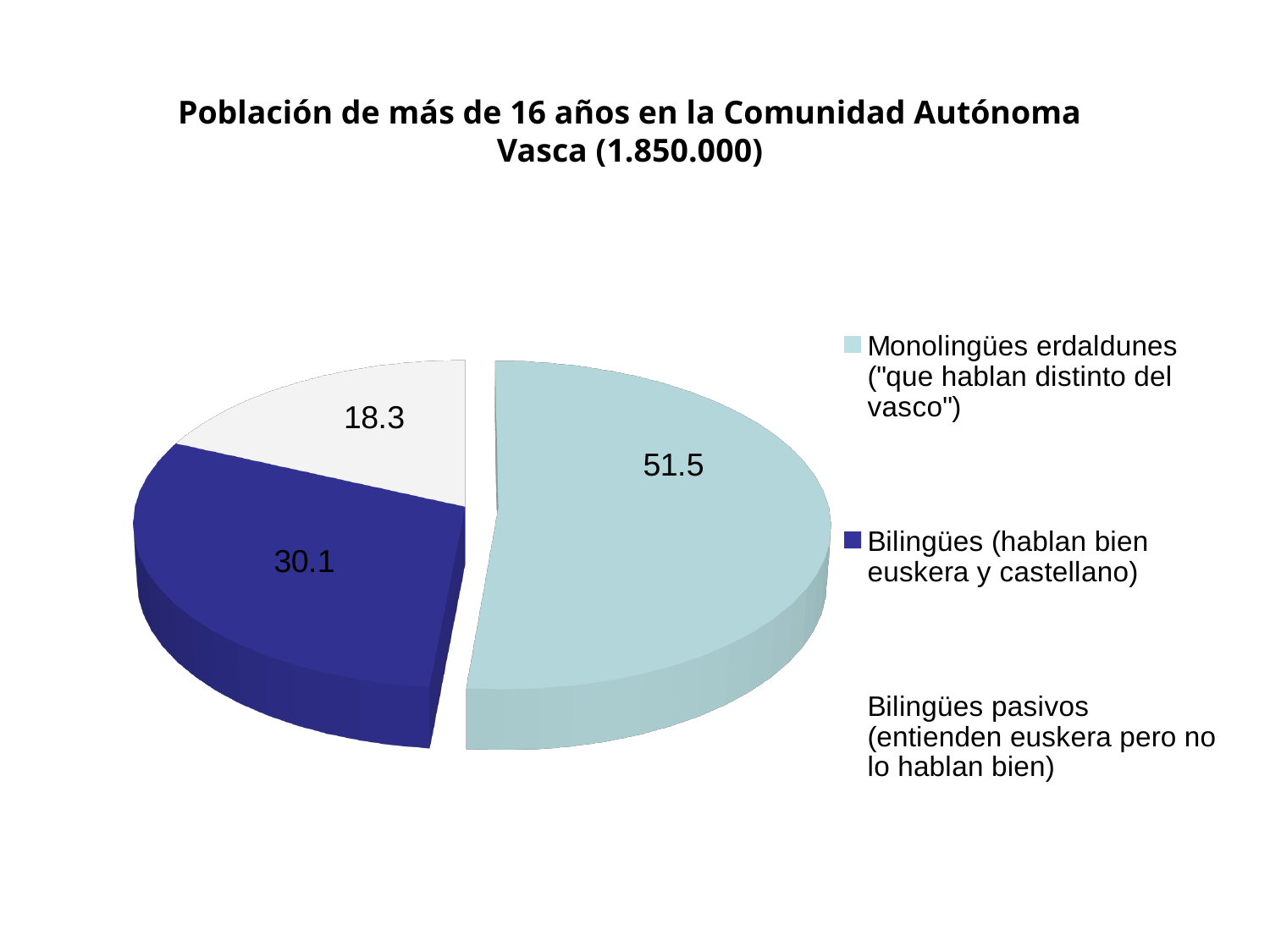
What colour is the slice for Bilingües (hablan bien euskera y castellano)? Dark blue How many slices does the pie chart have? 3 What is the title of the chart? Población de más de 16 años en la Comunidad Autónoma Vasca (1.850.000) What is the value for Bilingües pasivos? 18.3 What is the difference between the values for Monolingües erdaldunes and Bilingües (hablan bien euskera y castellano)? 21.4 What is the value for Monolingües erdaldunes? 51.5 What is the difference between the values for Bilingües (hablan bien euskera y castellano) and Bilingües pasivos? 11.8 Which is larger, the value for Bilingües (hablan bien euskera y castellano) or the value for Bilingües pasivos? Bilingües (hablan bien euskera y castellano) Which category has the largest slice? Monolingües erdaldunes What kind of chart is shown on the slide? Pie chart What is the value for Bilingües (hablan bien euskera y castellano)? 30.1 Which category has the smallest slice? Bilingües pasivos